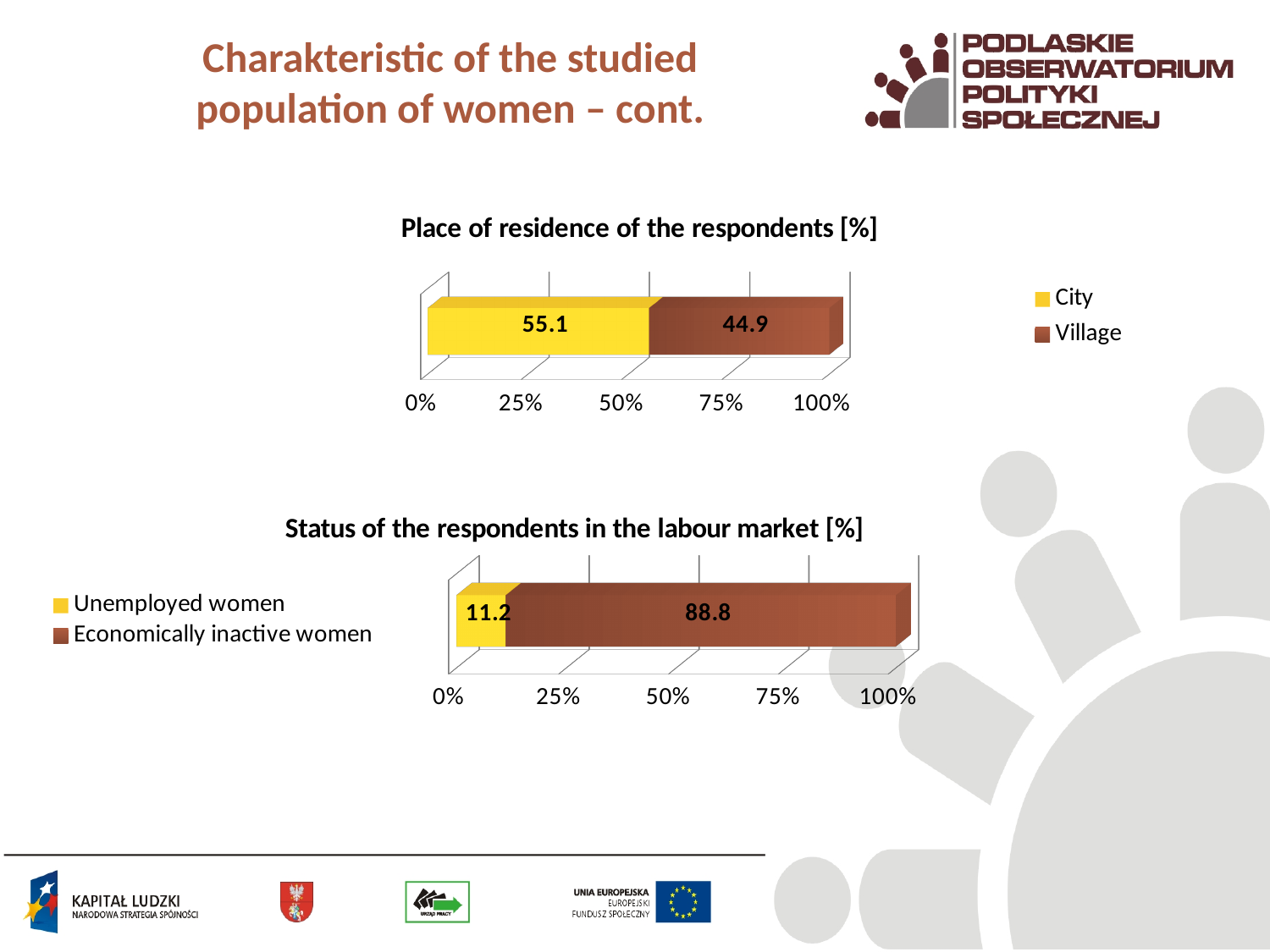
In the 'Place of residence of the respondents [%]' chart, how many series does the legend list? 2 In the 'Status of the respondents in the labour market [%]' chart, what is the value for Unemployed women? 11.2 In the 'Status of the respondents in the labour market [%]' chart, what is the value for Economically inactive women? 88.8 In the 'Place of residence of the respondents [%]' chart, what is the value for Village? 44.9 What kind of chart is the 'Status of the respondents in the labour market [%]' chart? Stacked bar chart In the 'Status of the respondents in the labour market [%]' chart, what is the difference between the Economically inactive women and Unemployed women values? 77.6 In the 'Status of the respondents in the labour market [%]' chart, what is the total of the stacked bar? 100 In the 'Place of residence of the respondents [%]' chart, which series has the larger value, City or Village? City In the 'Status of the respondents in the labour market [%]' chart, which series has the larger value? Economically inactive women In the 'Place of residence of the respondents [%]' chart, what is the value for City? 55.1 In the 'Place of residence of the respondents [%]' chart, what is the difference between the City and Village values? 10.2 In the 'Place of residence of the respondents [%]' chart, what colour represents Village? Brown